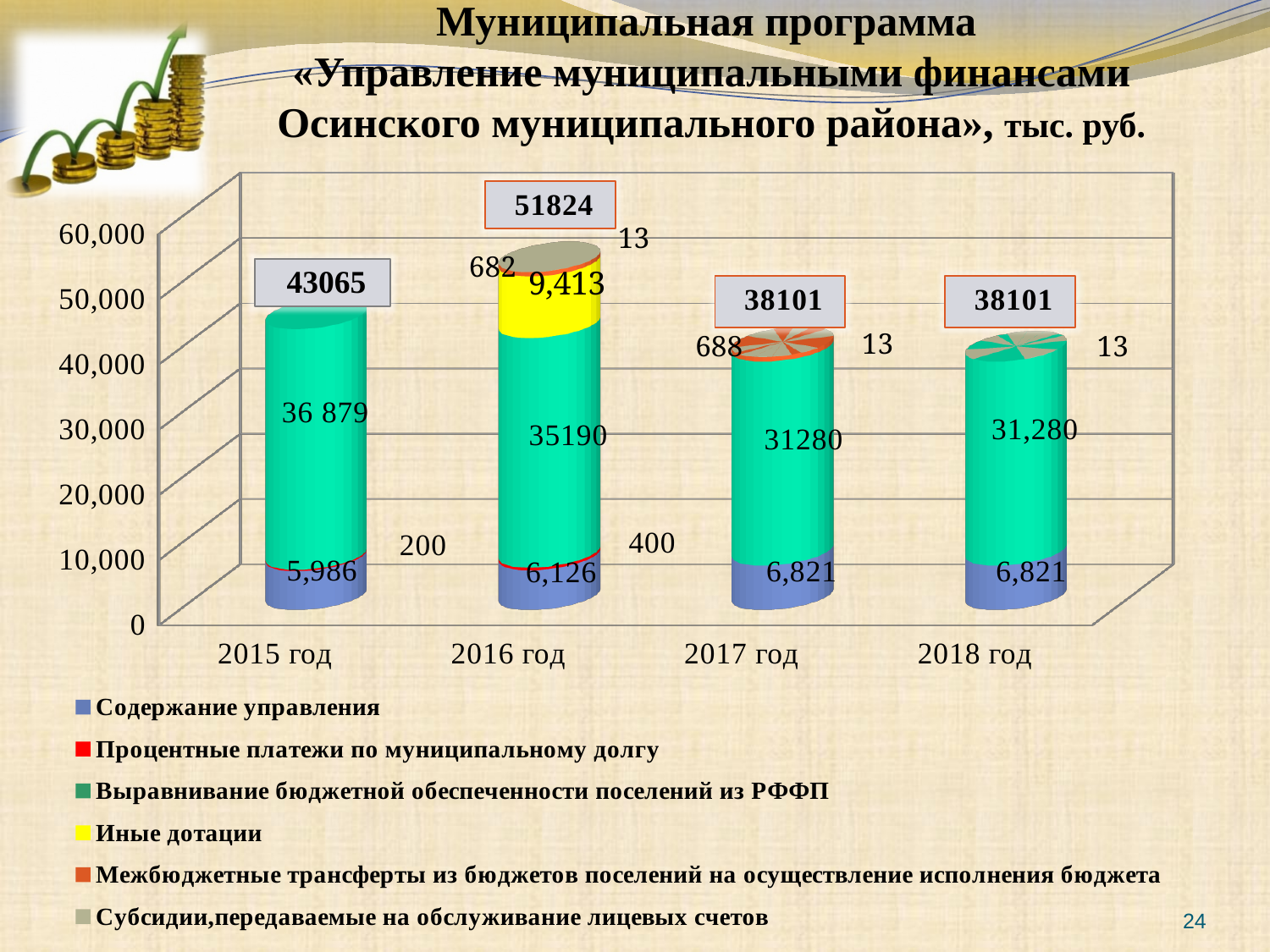
What is the value of Выравнивание бюджетной обеспеченности поселений из РФФП for 2015 год? 36 879 What is the difference between the total for 2016 год and the total for 2015 год? 8759 What kind of chart is shown on the slide? Stacked bar chart What is the total value shown for 2016 год? 51824 What is the value of Содержание управления for 2017 год? 6,821 What is the total value shown for 2015 год? 43065 Which year has the highest total value? 2016 год What is the value of Процентные платежи по муниципальному долгу for 2016 год? 400 Which is larger: Выравнивание бюджетной обеспеченности поселений из РФФП in 2015 год or in 2016 год? 2015 год How many years are shown on the x axis? 4 What is the value of Иные дотации for 2016 год? 9,413 How many series does the legend list? 6